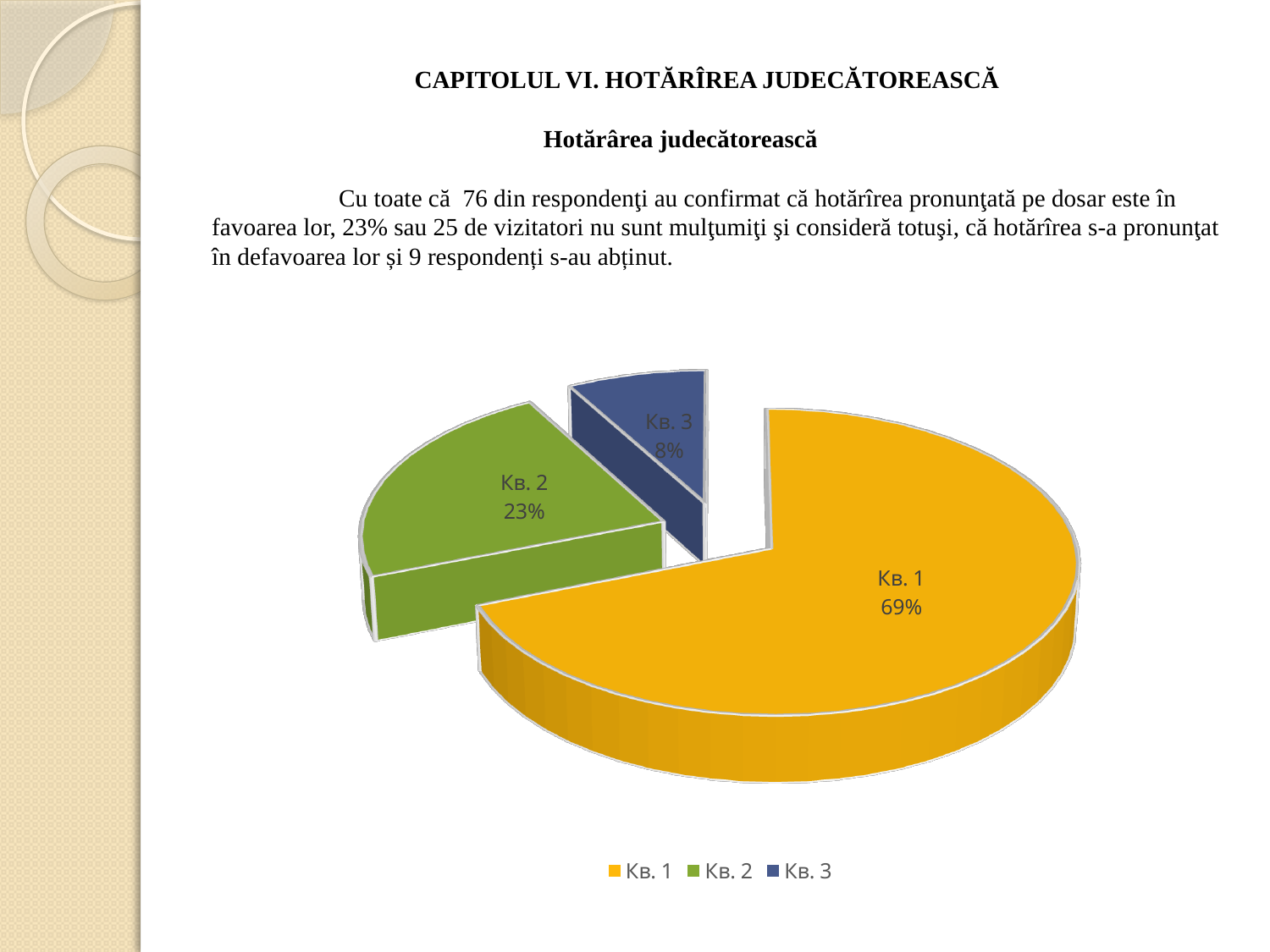
How many slices does the pie chart have? 3 Which slice of the pie is the largest? Кв. 1 What is the difference in percentage points between the Кв. 2 and Кв. 3 slices? 15 What colour is the Кв. 1 slice? Yellow How many entries does the legend list? 3 What is the difference in percentage points between the Кв. 1 and Кв. 2 slices? 46 What kind of chart is shown on the slide? Pie chart Which slice of the pie is the smallest? Кв. 3 Which slice is larger, Кв. 2 or Кв. 3? Кв. 2 What share of the pie does Кв. 3 represent? 8% What share of the pie does Кв. 1 represent? 69% What share of the pie does Кв. 2 represent? 23%